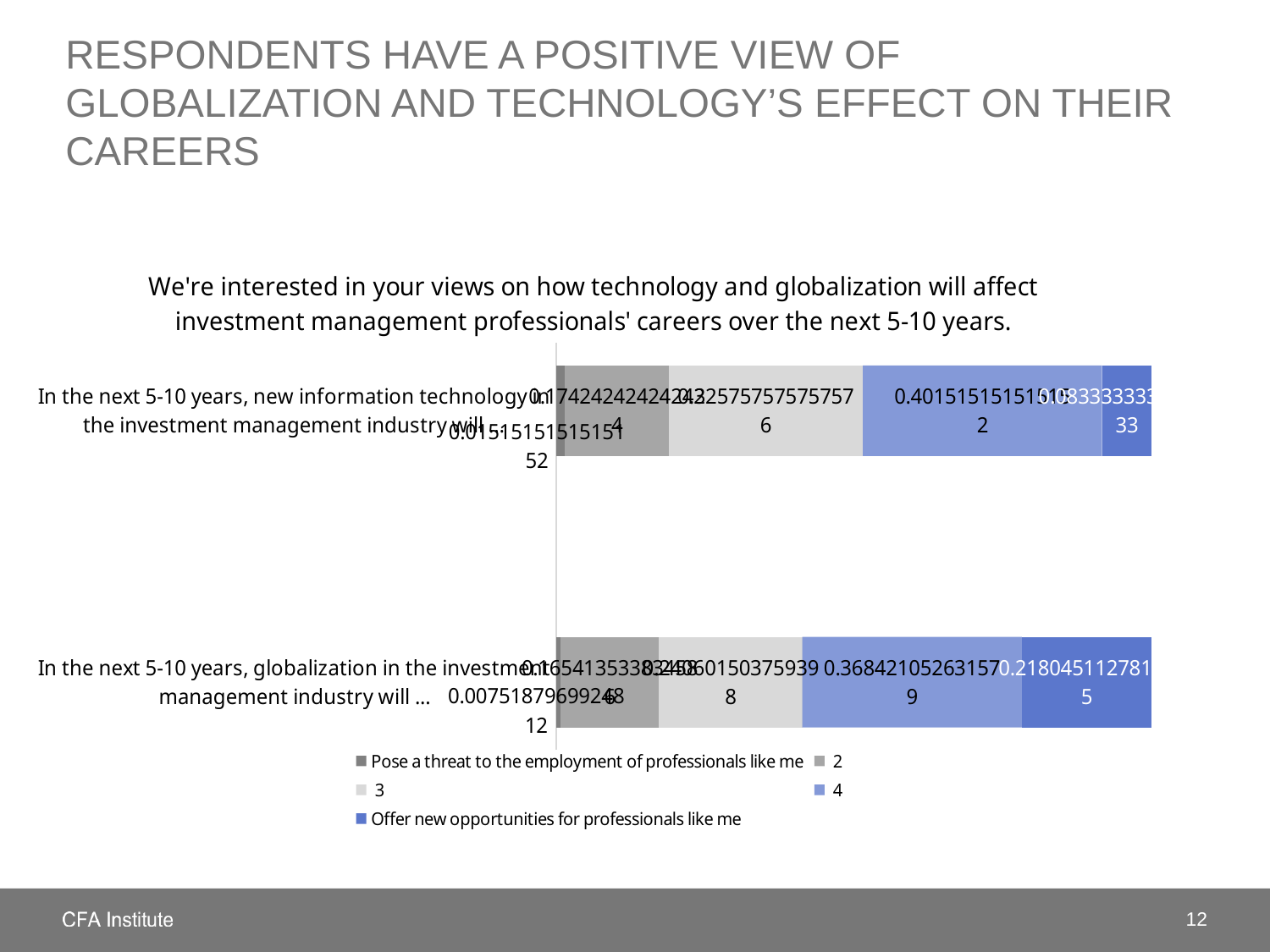
Which legend entry is represented by the dark grey segment at the left end of each bar? Pose a threat to the employment of professionals like me In the new information technology bar, is the segment for series 2 larger or smaller than the segment for series 3? Smaller Is the 'Offer new opportunities for professionals like me' segment larger for the globalization bar or for the new information technology bar? Globalization In the globalization bar, is the segment for series 3 larger or smaller than the segment for series 4? Smaller In the bar for new information technology, which series has the widest segment? 4 Which legend entry is represented by the darkest blue segment at the right end of each bar? Offer new opportunities for professionals like me How many categories (bars) are plotted in the chart? 2 In the bar for new information technology, which series has the narrowest segment? Pose a threat to the employment of professionals like me What kind of chart is shown on the slide? Stacked bar chart How many series does the legend list? 5 In the bar for globalization, which series has the widest segment? 4 In the bar for globalization, which series has the narrowest segment? Pose a threat to the employment of professionals like me